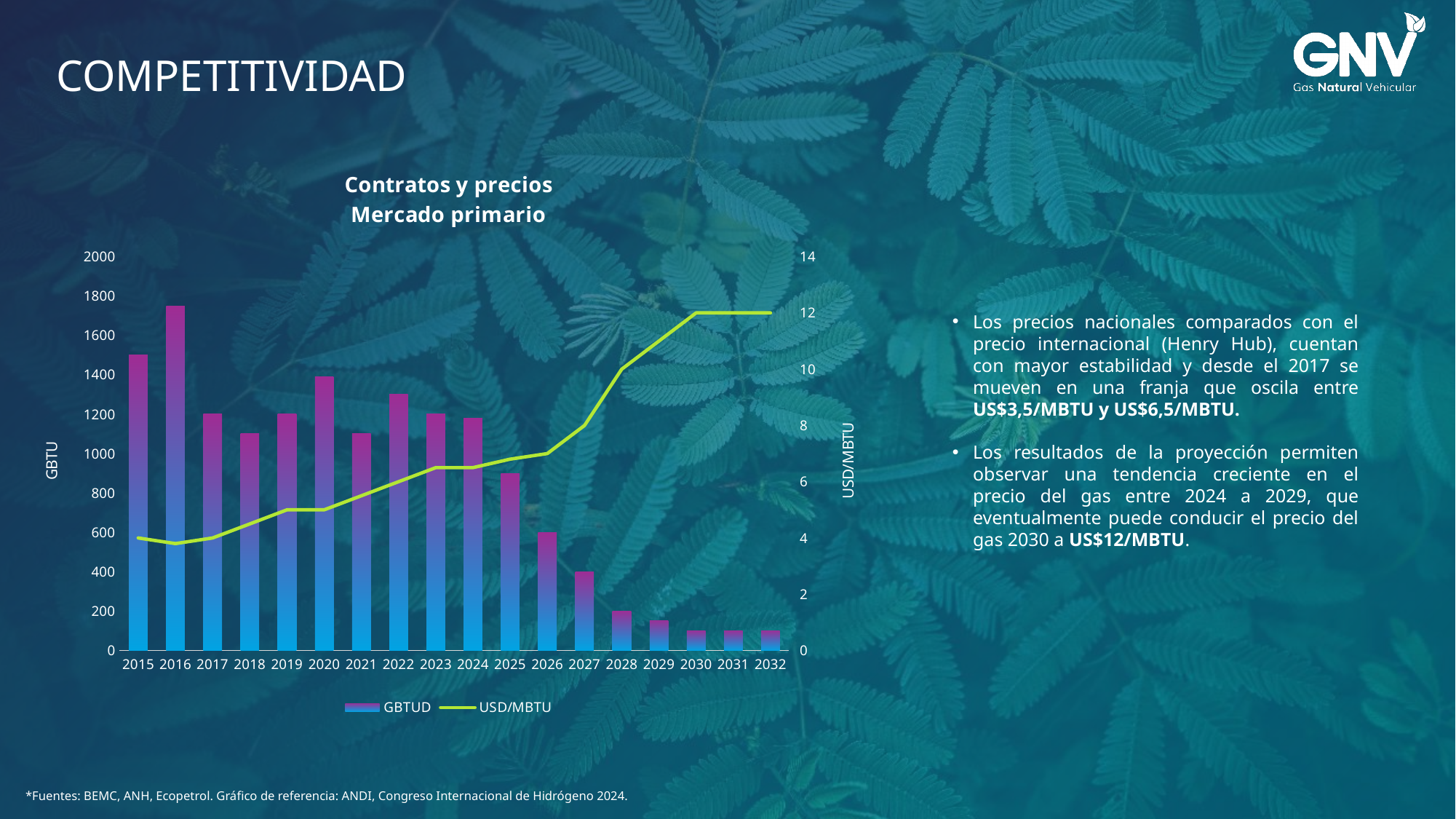
Does the USD/MBTU line generally rise or fall from 2015 to 2032? Rise What is the label of the left vertical axis of the chart? GBTU How many years are shown along the x axis of the chart? 18 Is the GBTUD value for 2015 greater or less than 1400? greater How many series does the chart legend list? 2 What kind of chart is shown on the slide? A combined bar and line chart Which year has the larger GBTUD bar, 2020 or 2025? 2020 What is the title of the chart? Contratos y precios Mercado primario Is the USD/MBTU value for 2030 greater or less than 10? greater Which year has the highest GBTUD bar? 2016 Is the GBTUD value for 2025 greater or less than 1000? less